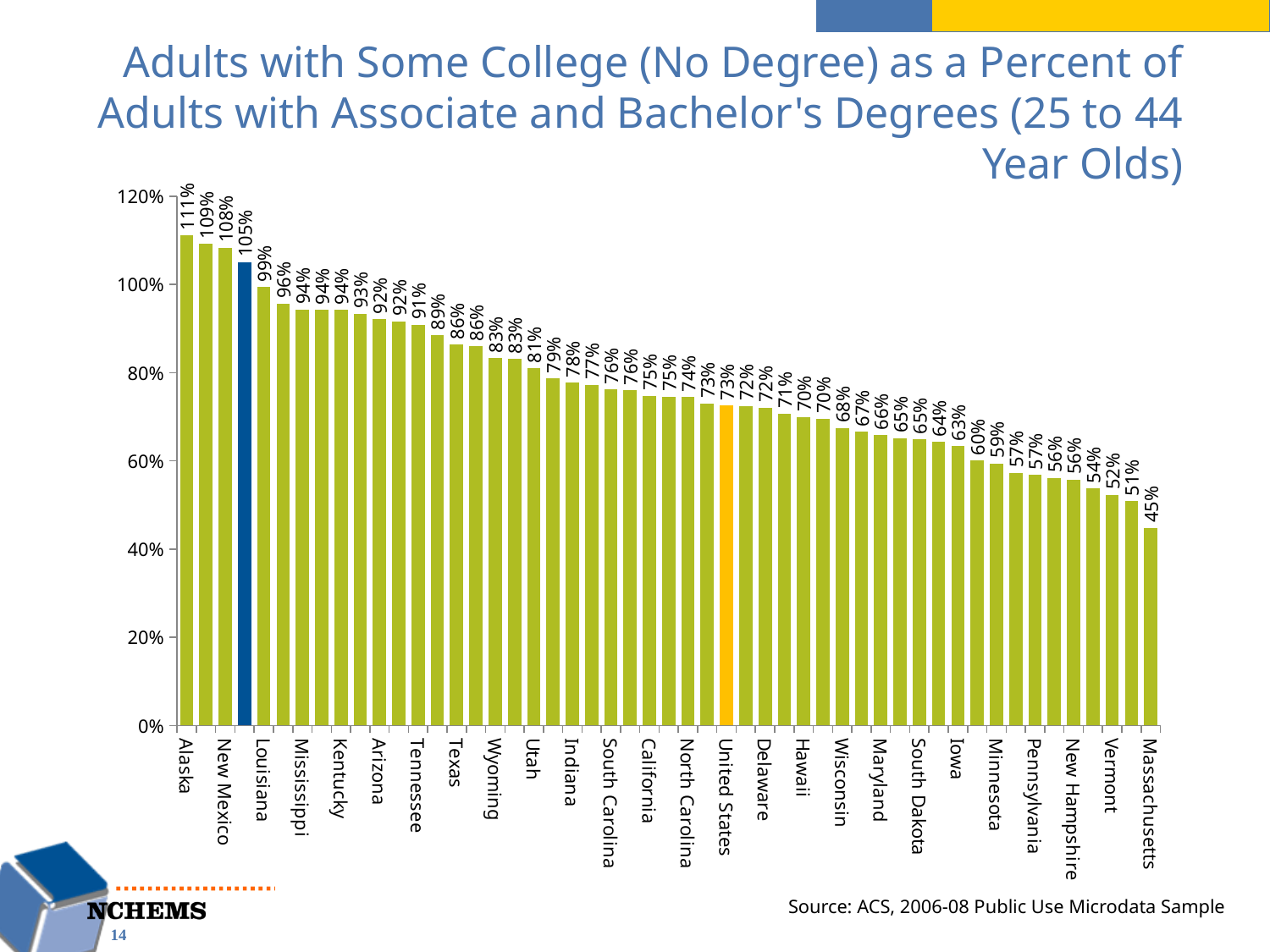
Is the value for Massachusetts greater or less than 60%? less Which is larger, the value for Alaska or the value for the United States? Alaska What is the value for the United States? 73% Which category has the lowest value? Massachusetts What is the difference between the values for Alaska and Massachusetts? 66 percentage points What data source is cited below the chart? ACS, 2006-08 Public Use Microdata Sample What is the value for Massachusetts? 45% How many bars are plotted in the chart? 51 What is the value for Alaska? 111% Do the values rise or fall moving from left to right along the x axis? Fall What kind of chart is shown on the slide? Bar chart Which category has the highest value? Alaska